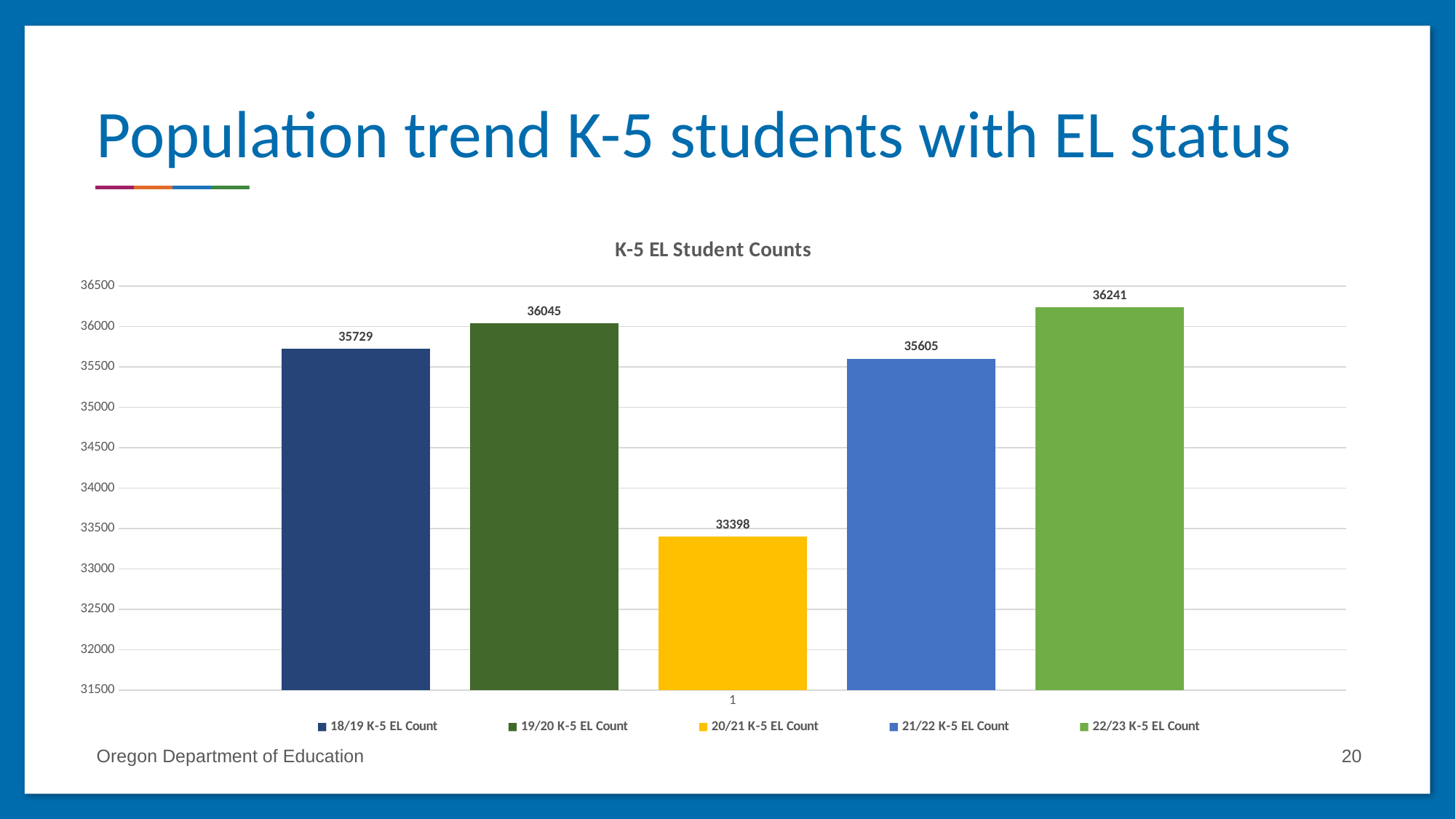
Is the 21/22 K-5 EL Count greater or less than 36000? less What is the 20/21 K-5 EL Count? 33398 What is the 18/19 K-5 EL Count? 35729 Which series has the highest K-5 EL count? 22/23 K-5 EL Count How many series does the legend list? 5 Which series has the lowest K-5 EL count? 20/21 K-5 EL Count What is the 22/23 K-5 EL Count? 36241 What is the title of the chart? K-5 EL Student Counts Which is larger, the 21/22 K-5 EL Count or the 19/20 K-5 EL Count? 19/20 K-5 EL Count What is the difference between the 19/20 K-5 EL Count and the 18/19 K-5 EL Count? 316 What kind of chart is shown on the slide? bar chart What is the difference between the 22/23 K-5 EL Count and the 20/21 K-5 EL Count? 2843